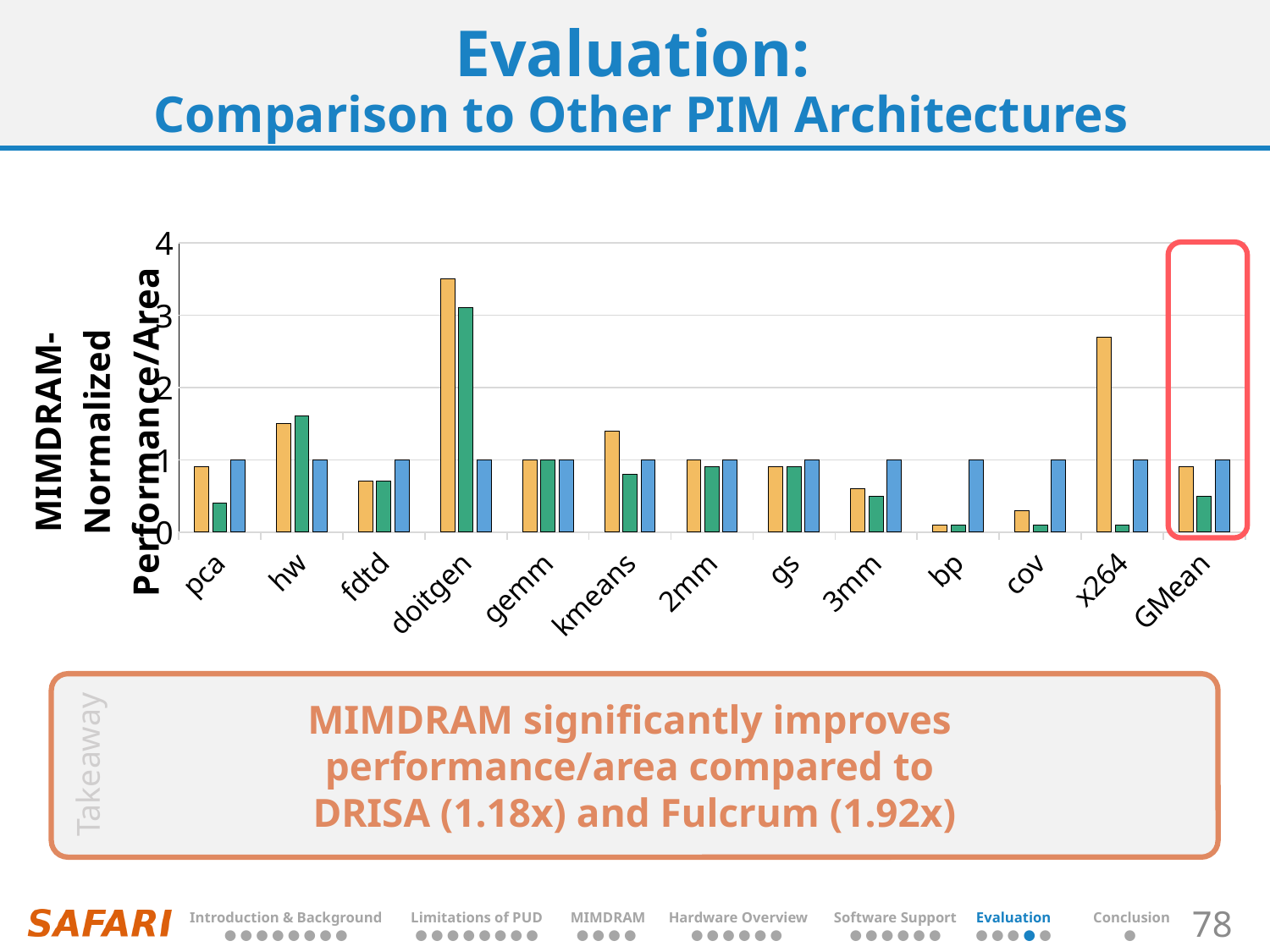
What is the value of the blue bar for GMean? 1 Is the orange bar for x264 greater or less than 2? greater How many bars are plotted for each category in the chart? 3 Is the orange bar for bp greater or less than 1? less Is the green bar for GMean greater or less than 1? less Which category on the x axis is highlighted with a red box? GMean Which category has the tallest orange bar in the chart? doitgen What kind of chart is shown on the slide? bar chart How many categories are shown along the x axis of the chart? 13 Which is larger, the green bar for hw or the green bar for fdtd? hw Which is larger, the orange bar for doitgen or the orange bar for x264? doitgen